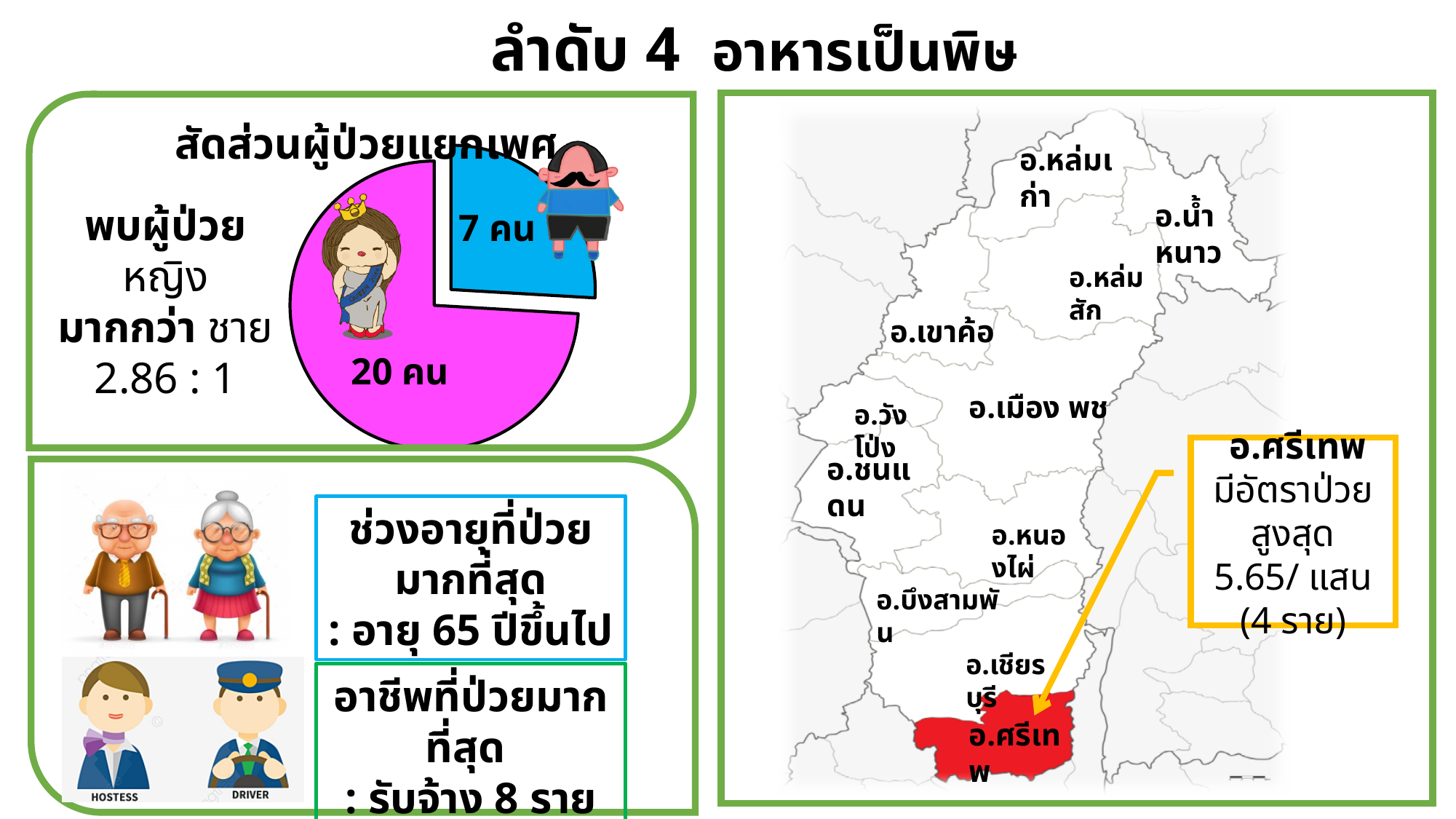
What is the title of the pie chart? สัดส่วนผู้ป่วยแยกเพศ What value is printed on the blue (male) slice of the pie chart? 7 คน What is the difference between the pink slice and the blue slice of the pie chart? 13 คน Is the pink slice or the blue slice of the pie chart larger? the pink slice What is the total number of patients represented in the pie chart? 27 คน What colour is the slice representing 7 คน in the pie chart? blue According to the text next to the pie chart, what is the ratio of female to male patients? 2.86 : 1 Which slice of the pie chart is the largest? the pink (female) slice, 20 คน What value is printed on the pink (female) slice of the pie chart? 20 คน What kind of chart is shown in the top-left box of the slide? pie chart How many slices does the pie chart have? 2 Which slice of the pie chart is the smallest? the blue (male) slice, 7 คน